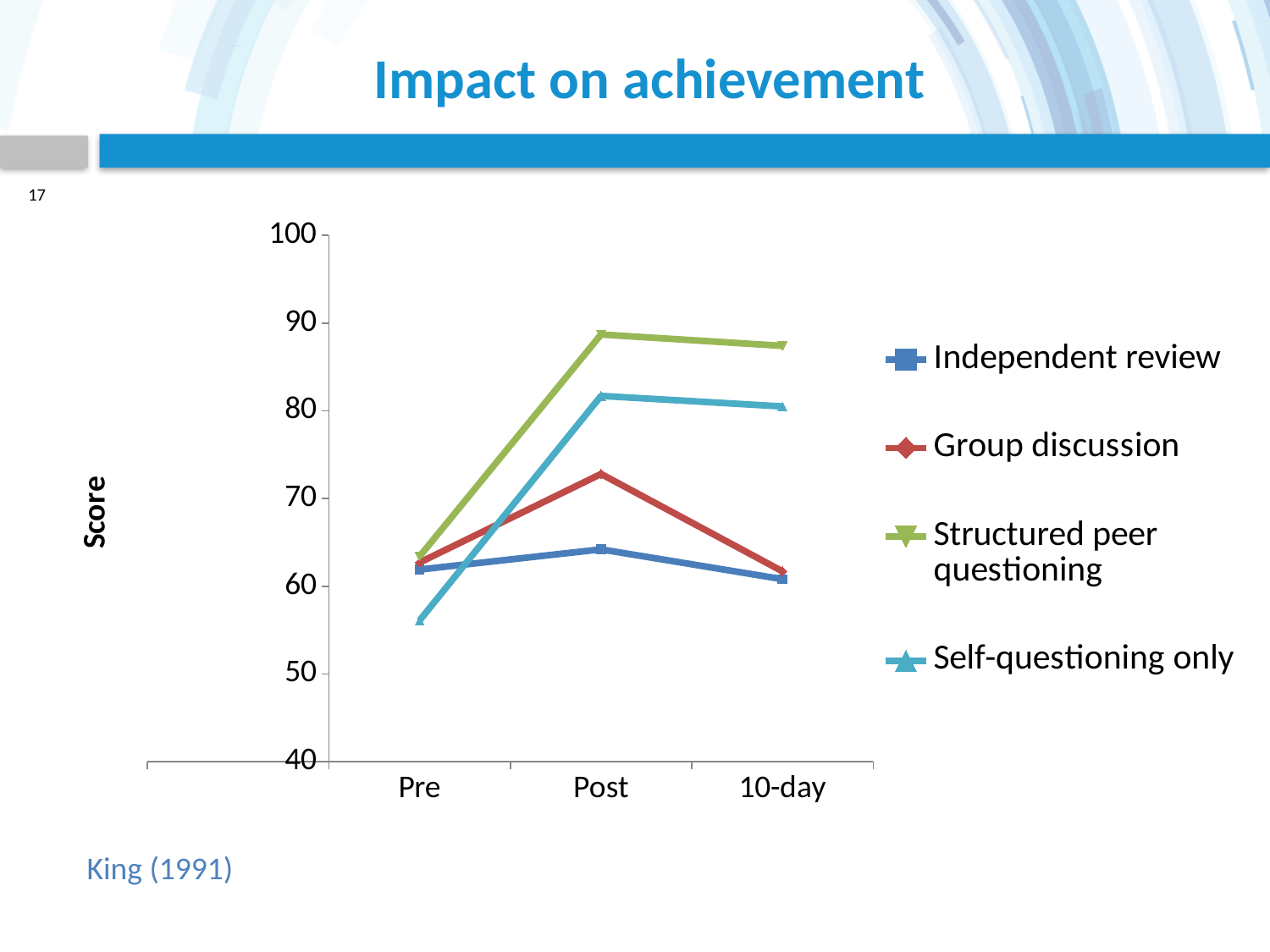
How many categories are shown on the x axis? 3 What is the label on the y axis? Score Is the value for Group discussion at Post greater or less than 70? greater Is the value for Structured peer questioning at Post greater or less than 80? greater Is the value for Self-questioning only at Pre greater or less than 60? less At 10-day, which is larger: Self-questioning only or Group discussion? Self-questioning only Does the Group discussion series rise or fall from Post to 10-day? fall How many series does the legend list? 4 Which series has the lowest score at Pre? Self-questioning only Which series has the highest score at Post? Structured peer questioning Which series has the lowest score at 10-day? Independent review What kind of chart is shown on the slide? line chart